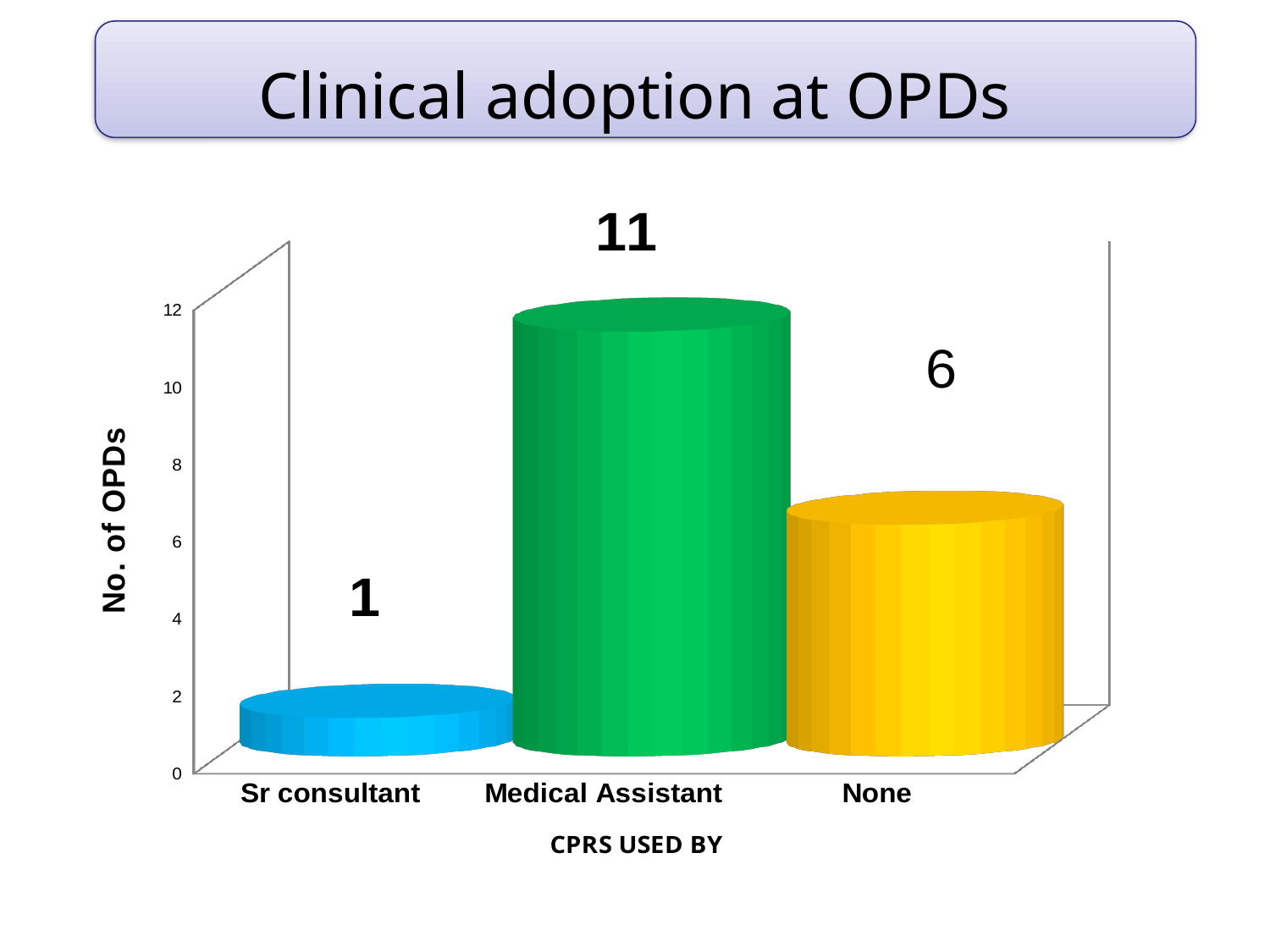
Which category has the highest number of OPDs? Medical Assistant Which category has the lowest number of OPDs? Sr consultant What is the label of the x axis? CPRS USED BY What is the title of the slide containing the chart? Clinical adoption at OPDs What is the number of OPDs where CPRS is used by Medical Assistant? 11 How many categories are shown on the x axis? 3 Which has more OPDs, None or Sr consultant? None What is the number of OPDs where CPRS is used by Sr consultant? 1 What is the difference in number of OPDs between None and Sr consultant? 5 What is the number of OPDs in the None category? 6 What kind of chart is shown on the slide? Bar chart What is the difference in number of OPDs between Medical Assistant and None? 5